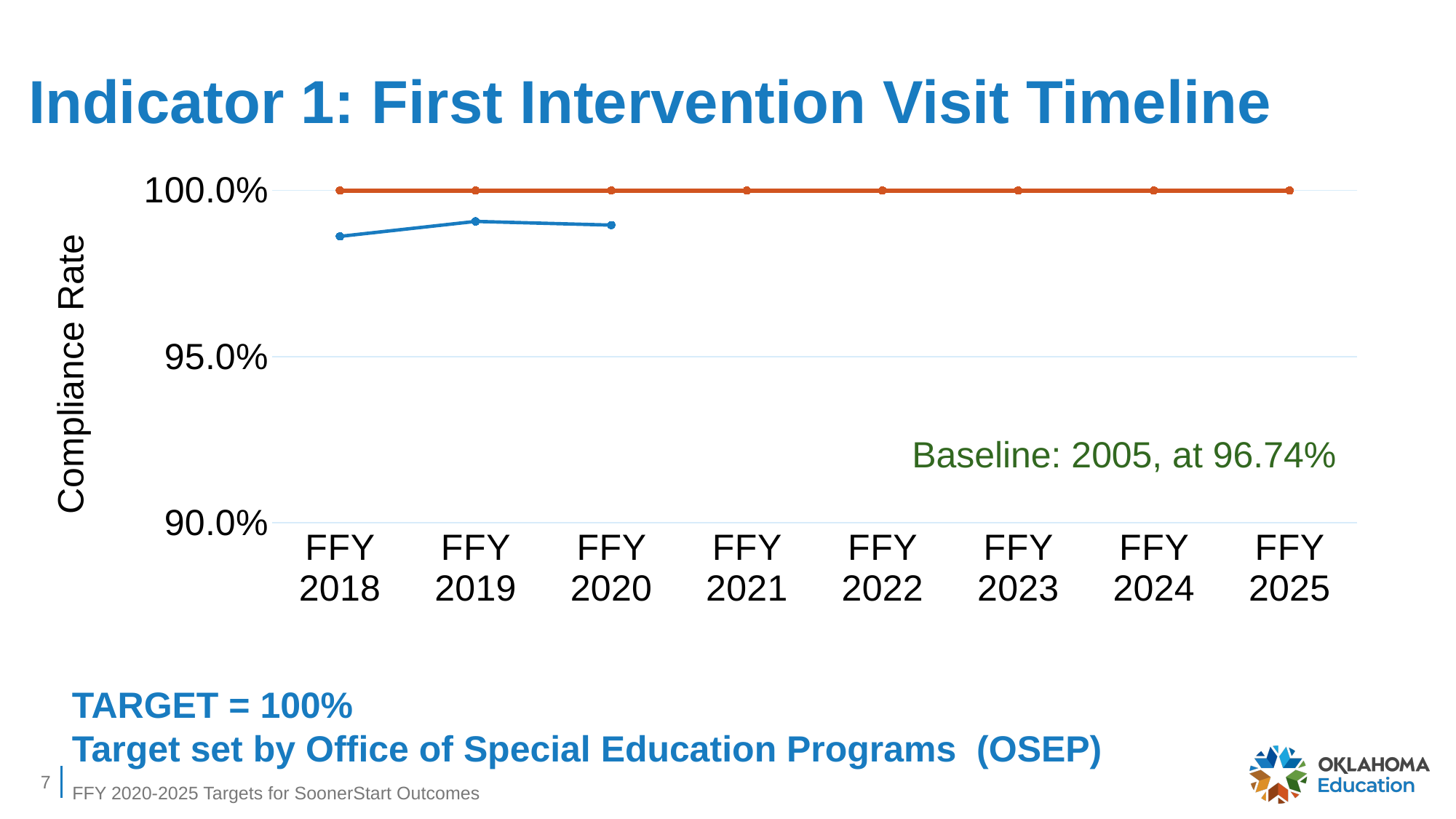
What kind of chart is shown on the slide? line chart Is the blue line's value for FFY 2020 greater or less than 100.0%? less Does the blue line rise or fall from FFY 2018 to FFY 2019? rise Which FFY has the lowest value on the blue line? FFY 2018 What baseline value is noted on the chart? 96.74% Which FFY has the highest value on the blue line? FFY 2019 How many data points does the blue line have? 3 What is the value of the orange target line at FFY 2021? 100.0% Is the blue line's value for FFY 2018 greater or less than 95.0%? greater What is the label of the y axis? Compliance Rate On the blue line, which is larger: the value for FFY 2018 or FFY 2019? FFY 2019 How many FFY categories are shown on the x axis? 8